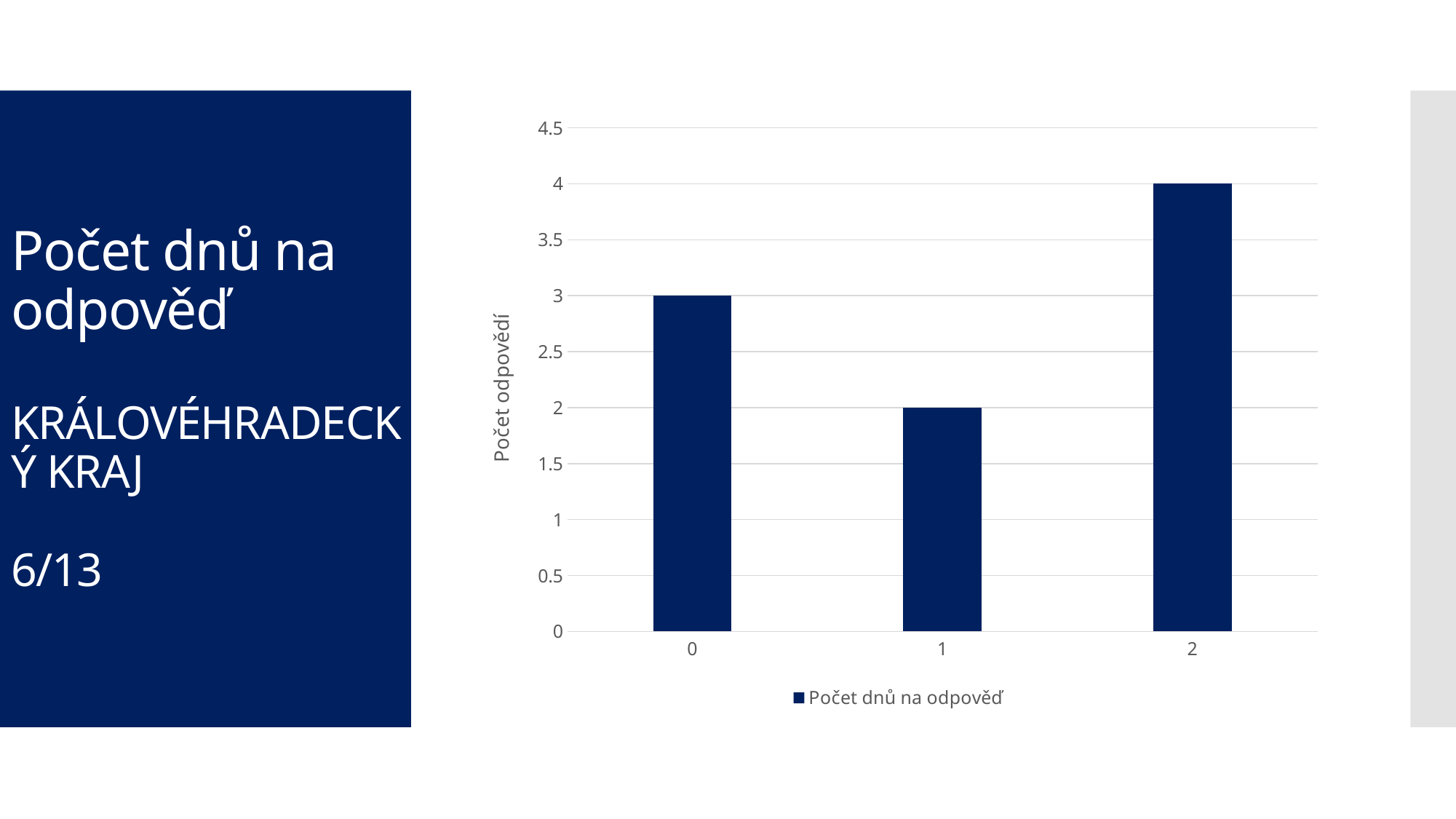
Which is larger, the value for category 0 or the value for category 1? 0 Is the value for category 2 greater or less than 3.5? greater Which category has the lowest value in the chart? 1 What is the difference between the values for category 2 and category 1? 2 What is the value for category 2 in the chart? 4 What is the name of the series shown in the chart legend? Počet dnů na odpověď What is the value for category 1 in the chart? 2 Which category has the highest value in the chart? 2 What type of chart is shown on the slide? bar chart How many series does the chart legend list? 1 What is the value for category 0 in the chart? 3 How many categories are shown on the x axis of the chart? 3